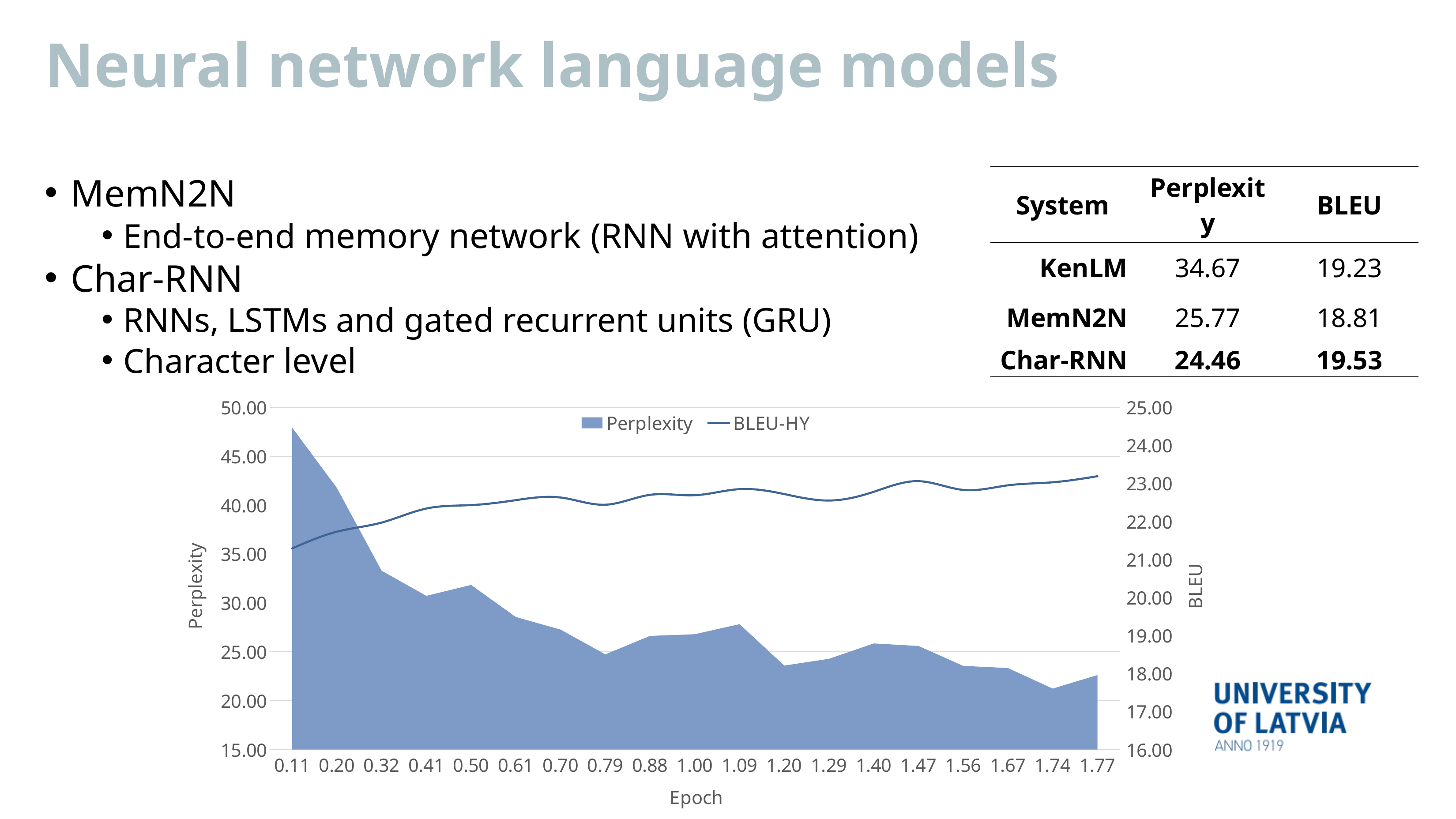
Does Perplexity generally rise or fall as the epoch increases? fall Is the Perplexity value at epoch 0.11 greater or less than 45.00? greater Is the BLEU-HY value at epoch 1.77 greater or less than 23.00? greater Which epoch has the higher Perplexity, 1.09 or 1.20? 1.09 At which epoch is Perplexity highest? 0.11 What kind of chart is shown on the slide? A combined area and line chart Is the BLEU-HY value at epoch 0.11 greater or less than 22.00? less What is the title of the x axis of the chart? Epoch How many epoch points are plotted along the x axis of the chart? 19 At which epoch is BLEU-HY lowest? 0.11 How many series does the chart legend list? 2